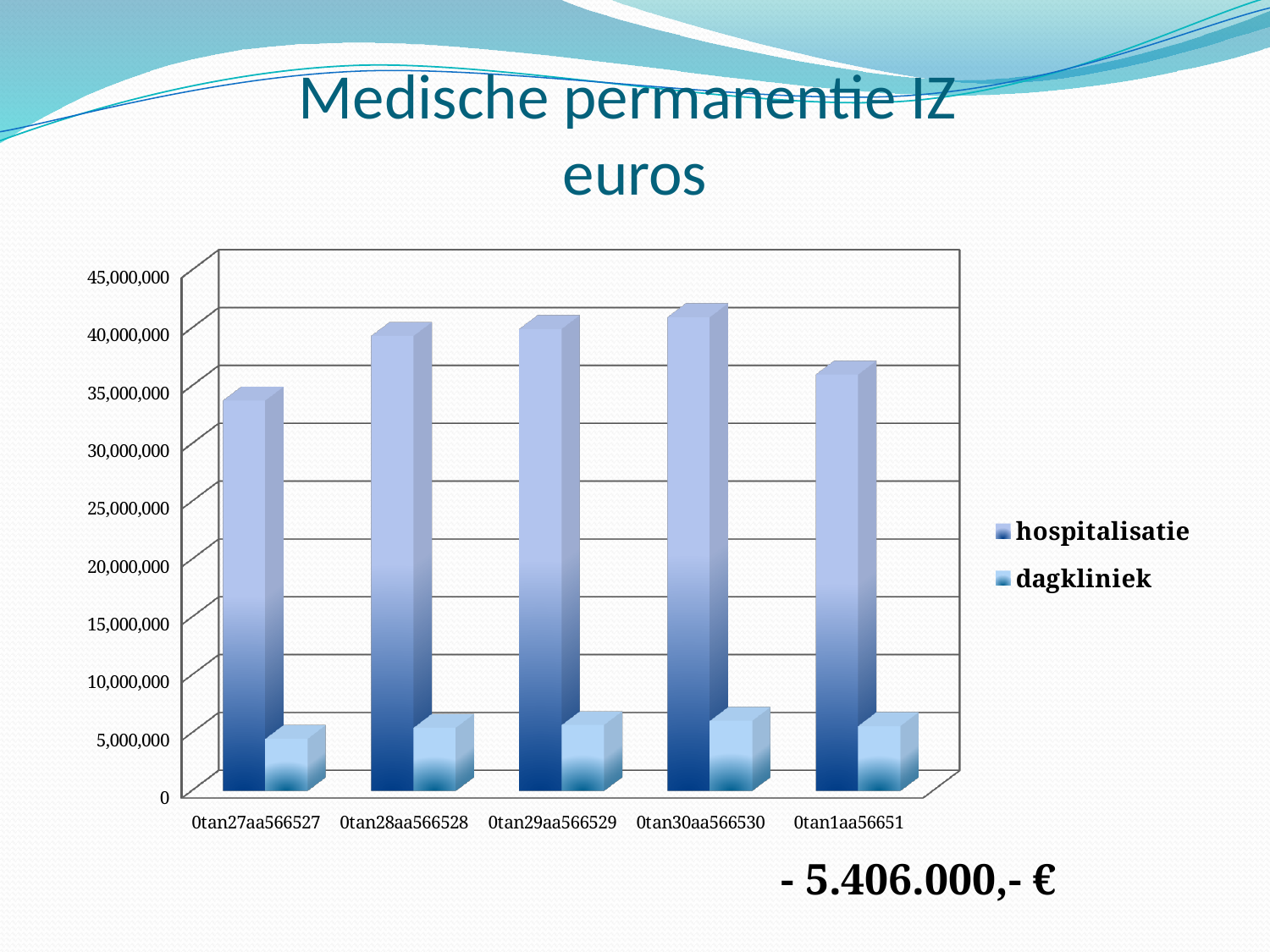
Which category has the lowest hospitalisatie value? 0tan27aa566527 Is the dagkliniek value for 0tan27aa566527 greater or less than 10,000,000? less How many series does the legend list? 2 What are the two series named in the legend? hospitalisatie and dagkliniek Which category has the highest hospitalisatie value? 0tan30aa566530 What kind of chart is shown on the slide? bar chart Is the hospitalisatie value for 0tan27aa566527 greater or less than 30,000,000? greater Is the hospitalisatie value for 0tan30aa566530 greater or less than 35,000,000? greater Does the hospitalisatie value rise or fall from 0tan27aa566527 to 0tan30aa566530? rise Which is larger for 0tan29aa566529, hospitalisatie or dagkliniek? hospitalisatie How many categories are shown on the x axis? 5 Which has the larger hospitalisatie value, 0tan27aa566527 or 0tan28aa566528? 0tan28aa566528